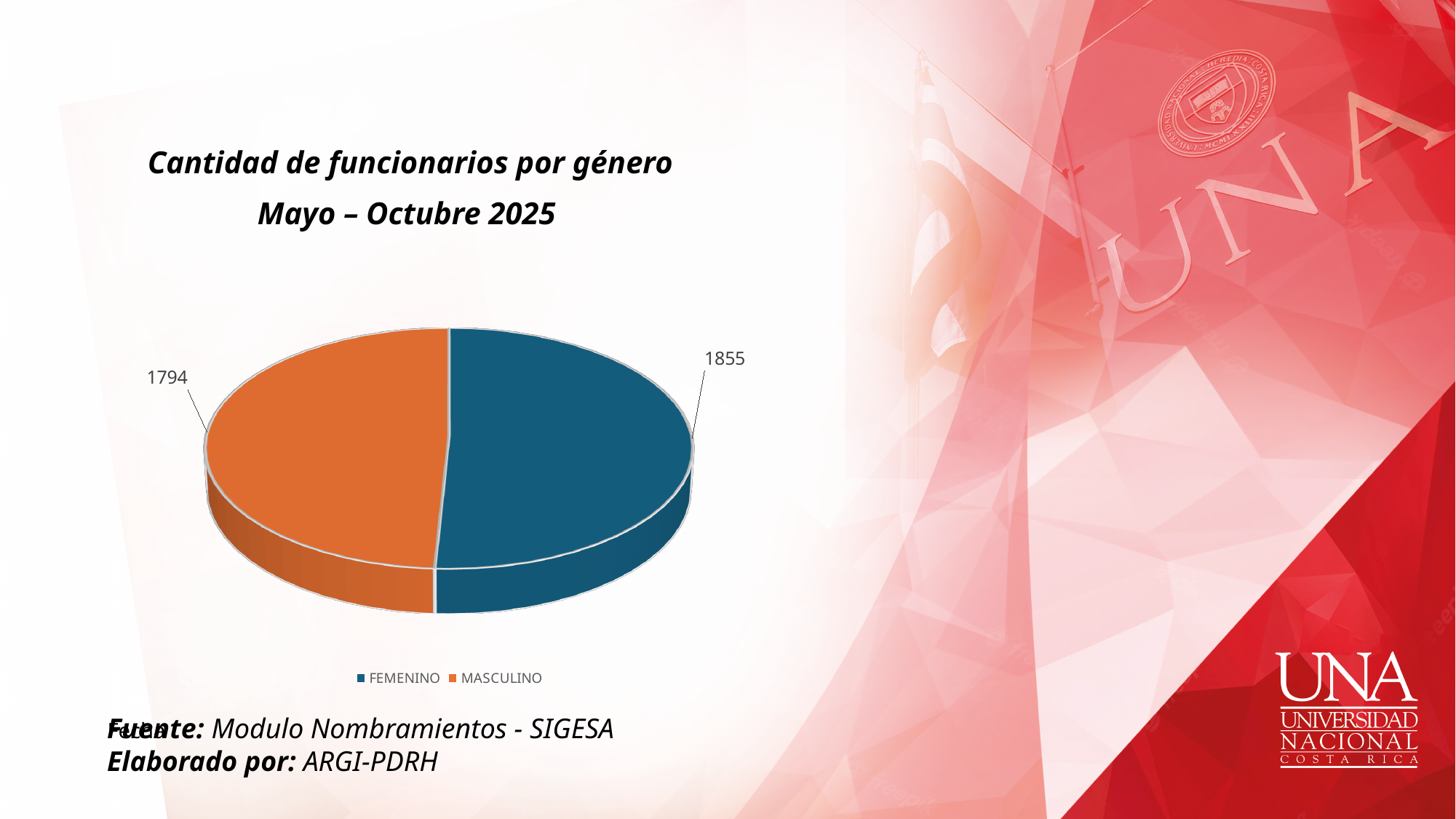
How many slices does the pie chart have? 2 Which category has the lowest value? MASCULINO What is the value for FEMENINO? 1855 Which is larger, the value for FEMENINO or the value for MASCULINO? FEMENINO What is the total of the two values shown in the pie chart? 3649 Which category has the highest value? FEMENINO What is the difference between the FEMENINO and MASCULINO values? 61 What kind of chart is shown on the slide? Pie chart What is the value for MASCULINO? 1794 Which colour represents MASCULINO in the pie chart? Orange How many entries does the legend list? 2 What is the title of the chart? Cantidad de funcionarios por género Mayo – Octubre 2025